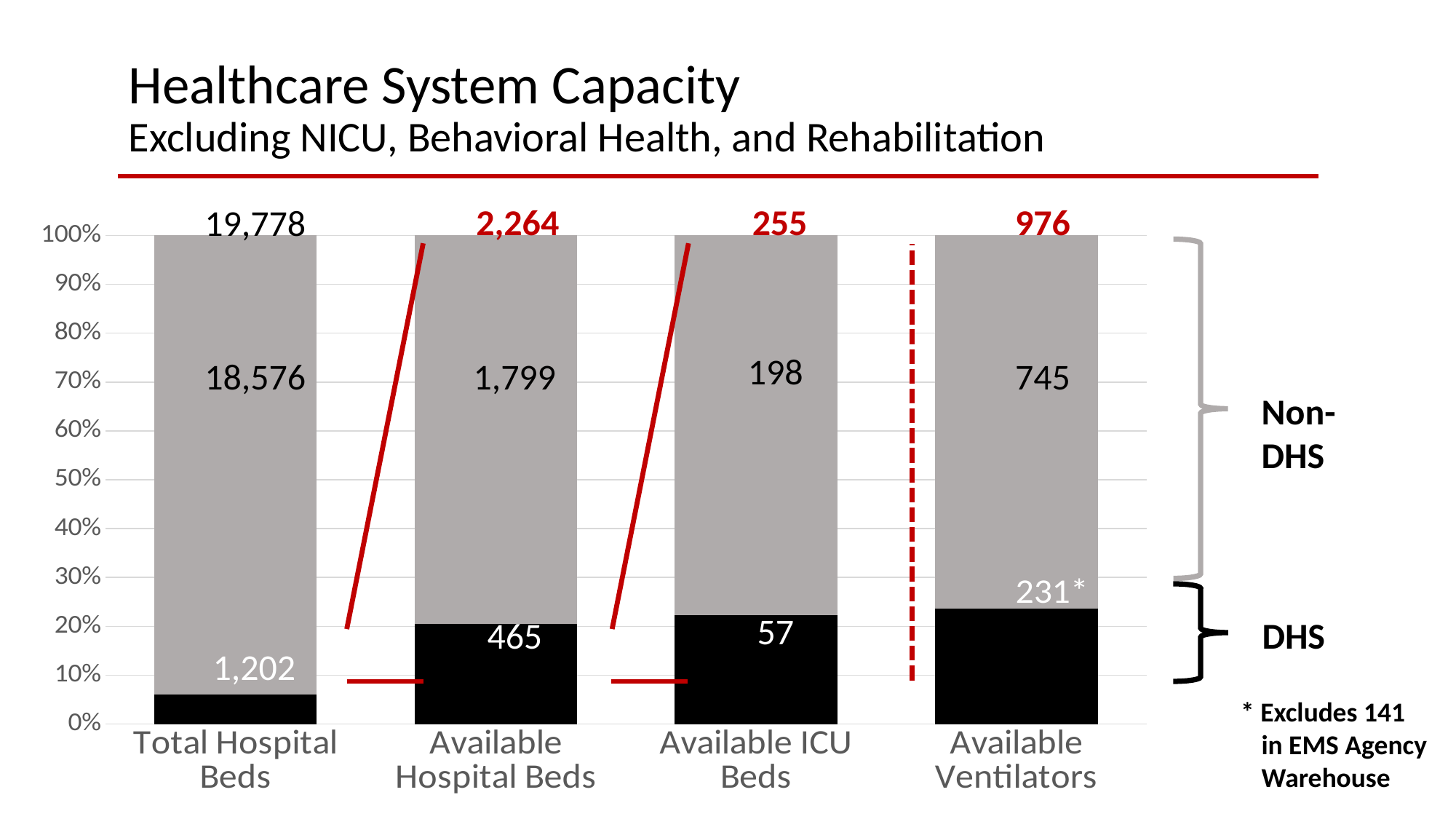
What is the DHS value for Available ICU Beds? 57 What is the Non-DHS value for Available Hospital Beds? 1,799 What is the DHS value for Total Hospital Beds? 1,202 What is the total shown above the Available Hospital Beds bar? 2,264 What is the Non-DHS value for Available Ventilators? 745 What kind of chart is shown on the slide? Stacked bar chart Which category has the lowest DHS value? Available ICU Beds How many categories are shown on the x axis? 4 What is the difference between the Non-DHS and DHS values for Available Hospital Beds? 1,334 Which category has the highest total value? Total Hospital Beds What is the total shown above the Available ICU Beds bar? 255 Is the DHS share of Available Ventilators greater or less than 20%? greater